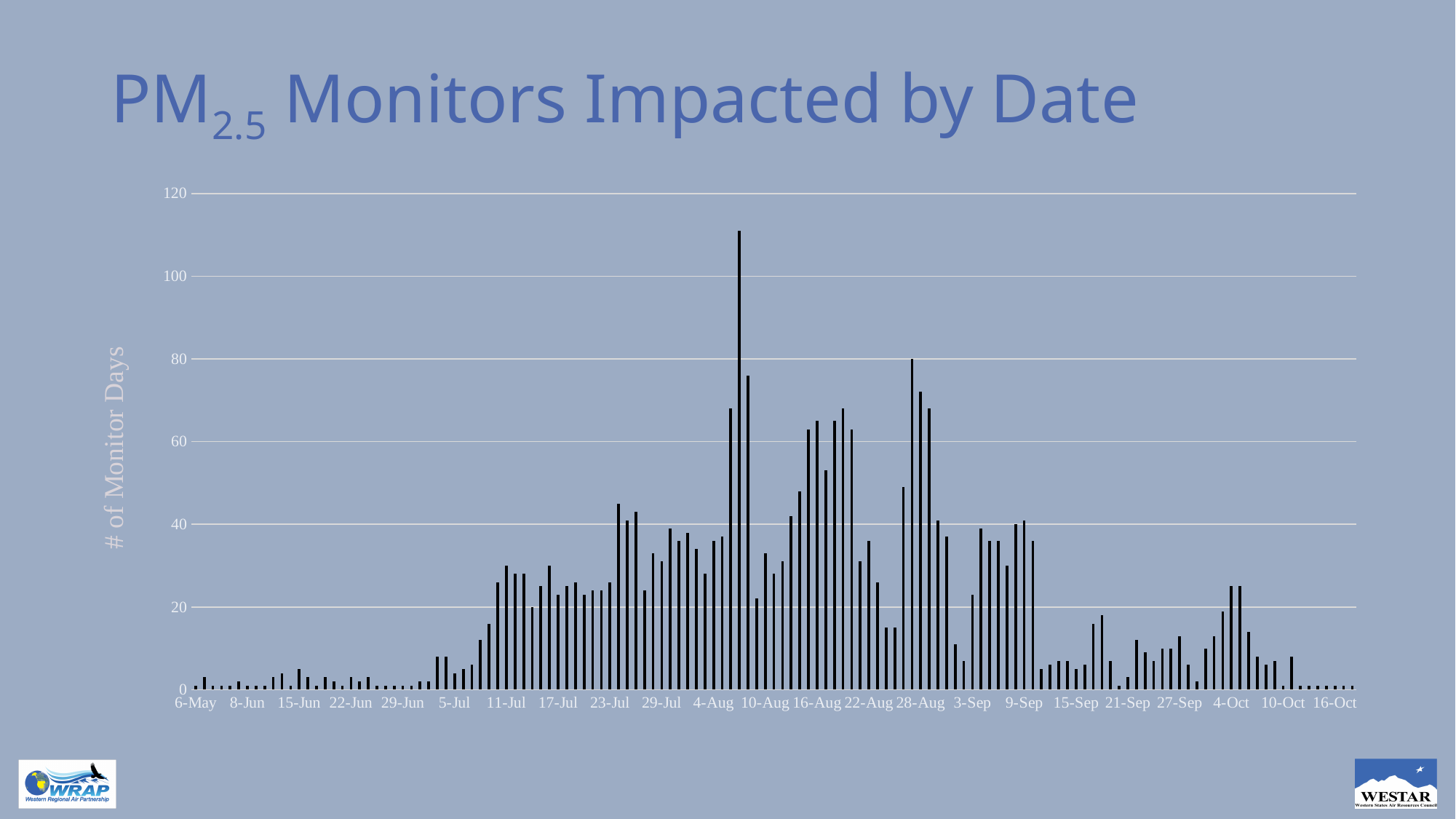
In which month does the tallest bar of the chart occur? August Is the value for 28-Aug greater or less than 60? greater Is the value for 9-Sep greater or less than 20? greater Is the value for 16-Aug greater or less than 40? greater What is the title of the chart on the slide? PM2.5 Monitors Impacted by Date What is the label on the vertical axis of the chart? # of Monitor Days What kind of chart is shown on the slide? bar chart